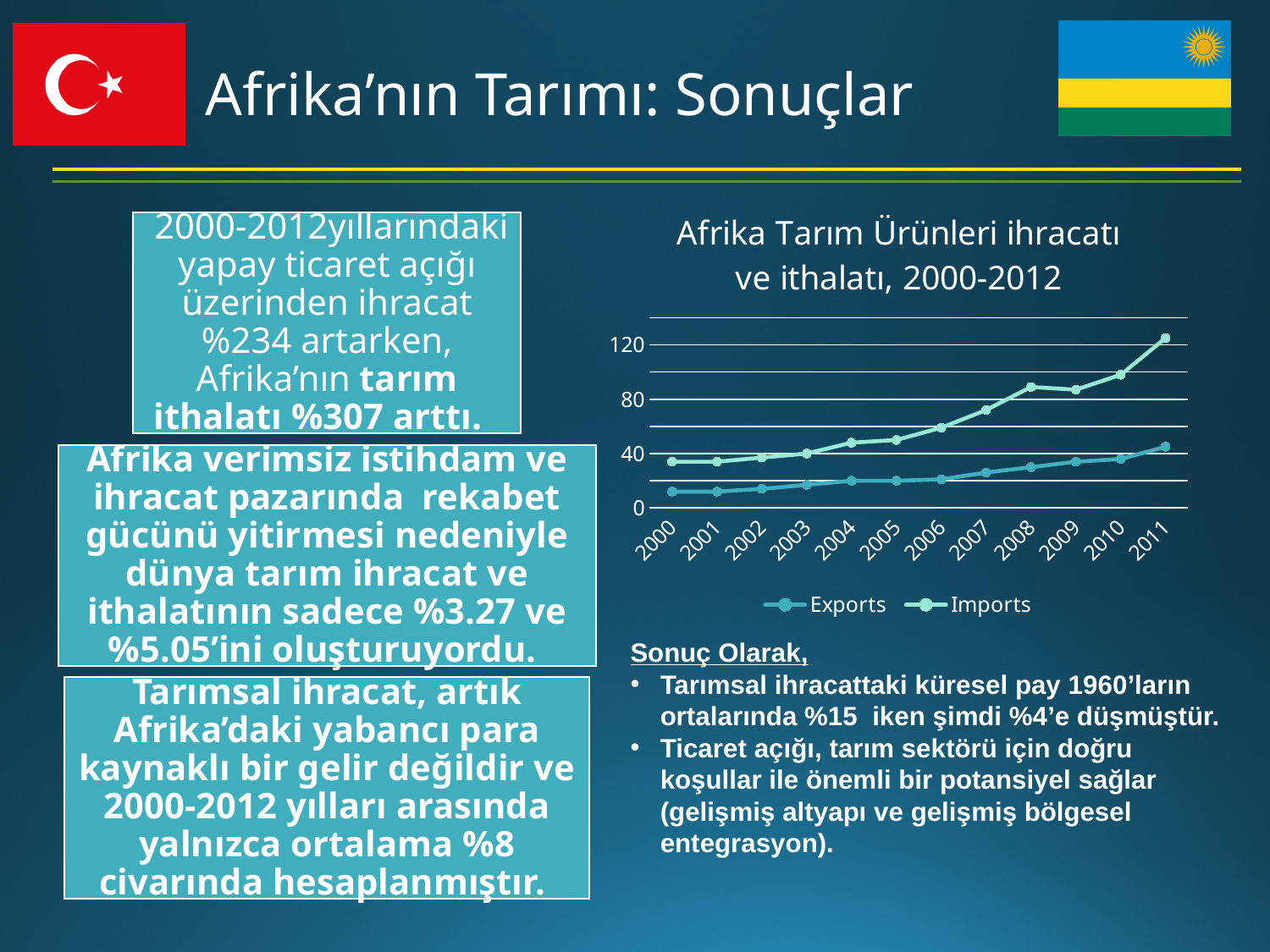
How many years are plotted along the x axis of the chart? 12 Do the Imports values rise or fall from 2000 to 2011? rise What kind of chart is shown on the slide? line chart In which year is the Imports value highest? 2011 In 2011, which series has the larger value, Exports or Imports? Imports How many series does the chart legend list? 2 Which series are listed in the chart legend? Exports and Imports Is the Exports value for 2000 greater or less than 40? less Do the Exports values rise or fall from 2000 to 2011? rise What is the title of the chart? Afrika Tarım Ürünleri ihracatı ve ithalatı, 2000-2012